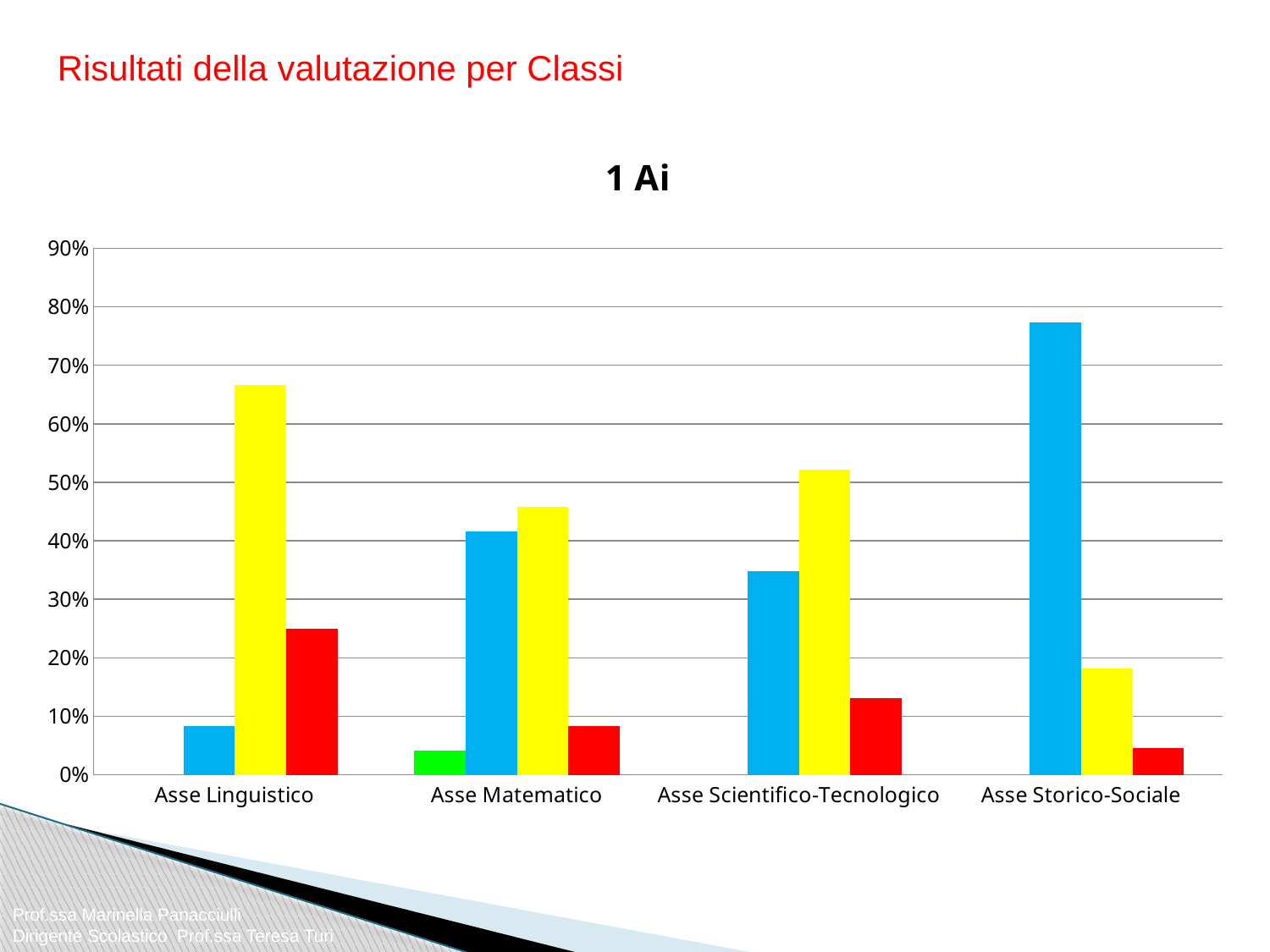
How many categories are shown on the x axis of the chart? 4 For Asse Storico-Sociale, which is larger, the blue bar or the yellow bar? the blue bar Which category has the tallest blue bar? Asse Storico-Sociale What is the title of the chart? 1 Ai Is the yellow bar for Asse Linguistico greater or less than 60%? greater What kind of chart is shown on the slide? bar chart Is the blue bar for Asse Scientifico-Tecnologico greater or less than 40%? less Is the yellow bar for Asse Storico-Sociale greater or less than 30%? less Which category has the tallest yellow bar? Asse Linguistico Which category has the shortest red bar? Asse Storico-Sociale